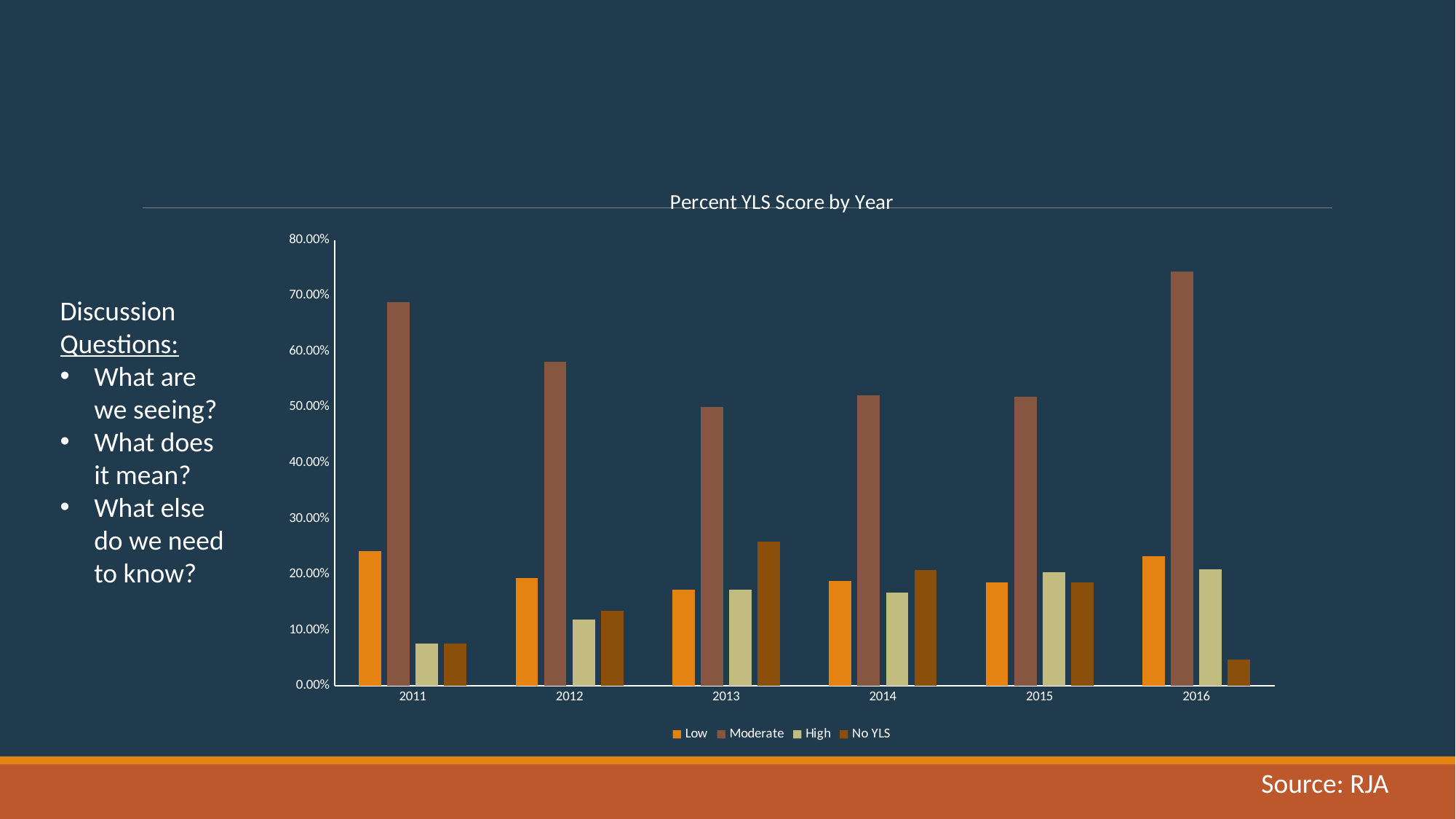
In which year is the Moderate bar the highest? 2016 Is the value for Moderate in 2011 greater or less than 60.00%? greater Does the Moderate series rise or fall from 2011 to 2013? fall What is the title of the chart? Percent YLS Score by Year In which year is the No YLS bar the lowest? 2016 Which is larger, the Moderate value in 2012 or the Moderate value in 2013? 2012 Is the value for High in 2011 greater or less than 10.00%? less What kind of chart is shown on the slide? bar chart Is the value for No YLS in 2013 greater or less than 20.00%? greater How many years are shown on the x axis? 6 How many series does the legend list? 4